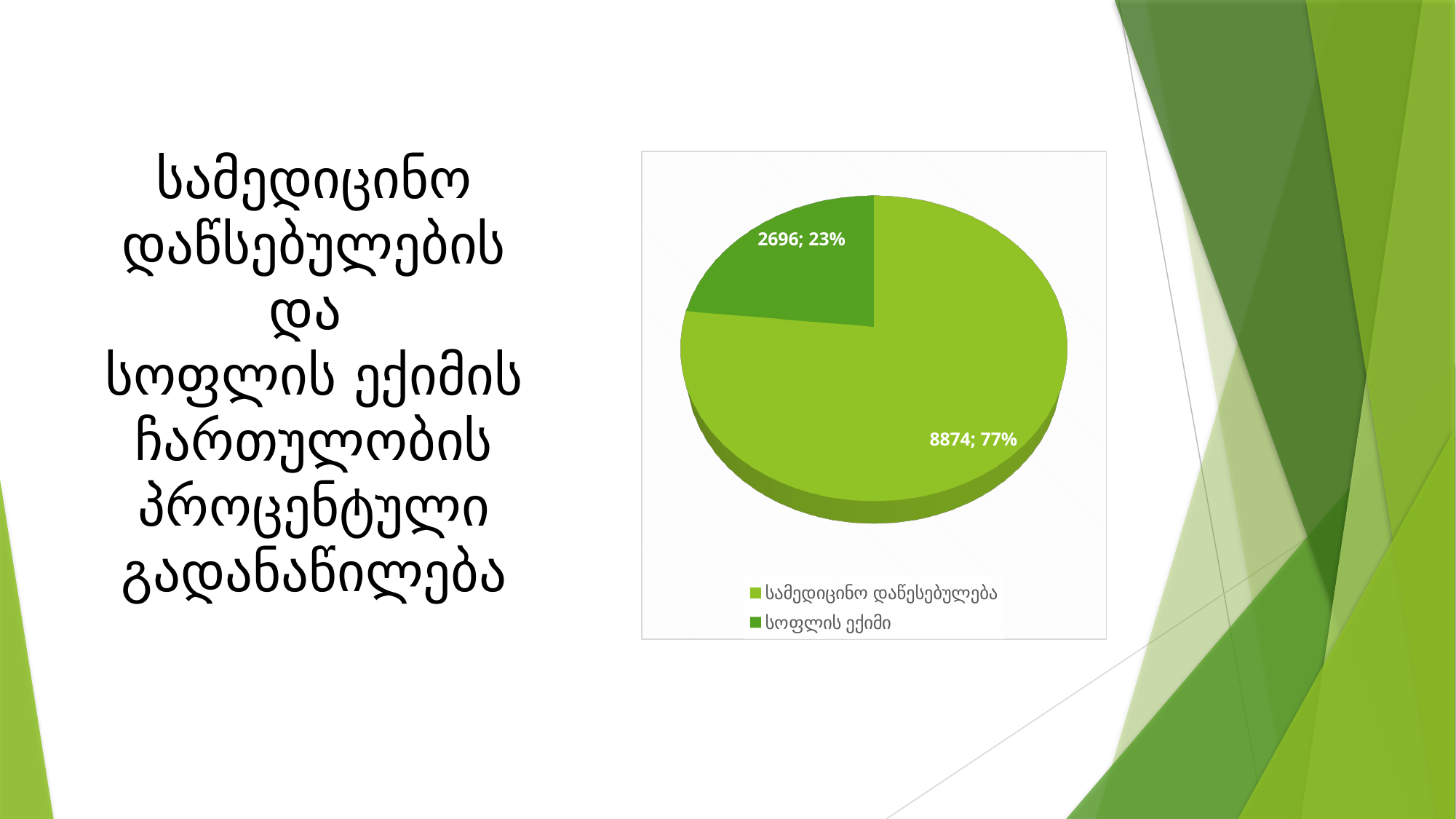
Which slice of the pie chart is the smallest? სოფლის ექიმი What value is shown for the სამედიცინო დაწესებულება slice? 8874 Which is larger, the value for სამედიცინო დაწესებულება or the value for სოფლის ექიმი? სამედიცინო დაწესებულება What kind of chart is shown on the slide? pie chart What percentage share does the სამედიცინო დაწესებულება slice have? 77% How many slices does the pie chart have? 2 Which slice of the pie chart is the largest? სამედიცინო დაწესებულება What value is shown for the სოფლის ექიმი slice? 2696 What percentage share does the სოფლის ექიმი slice have? 23% What is the total of the two values shown in the pie chart? 11570 What is the difference between the values for სამედიცინო დაწესებულება and სოფლის ექიმი? 6178 How many entries does the legend of the pie chart list? 2